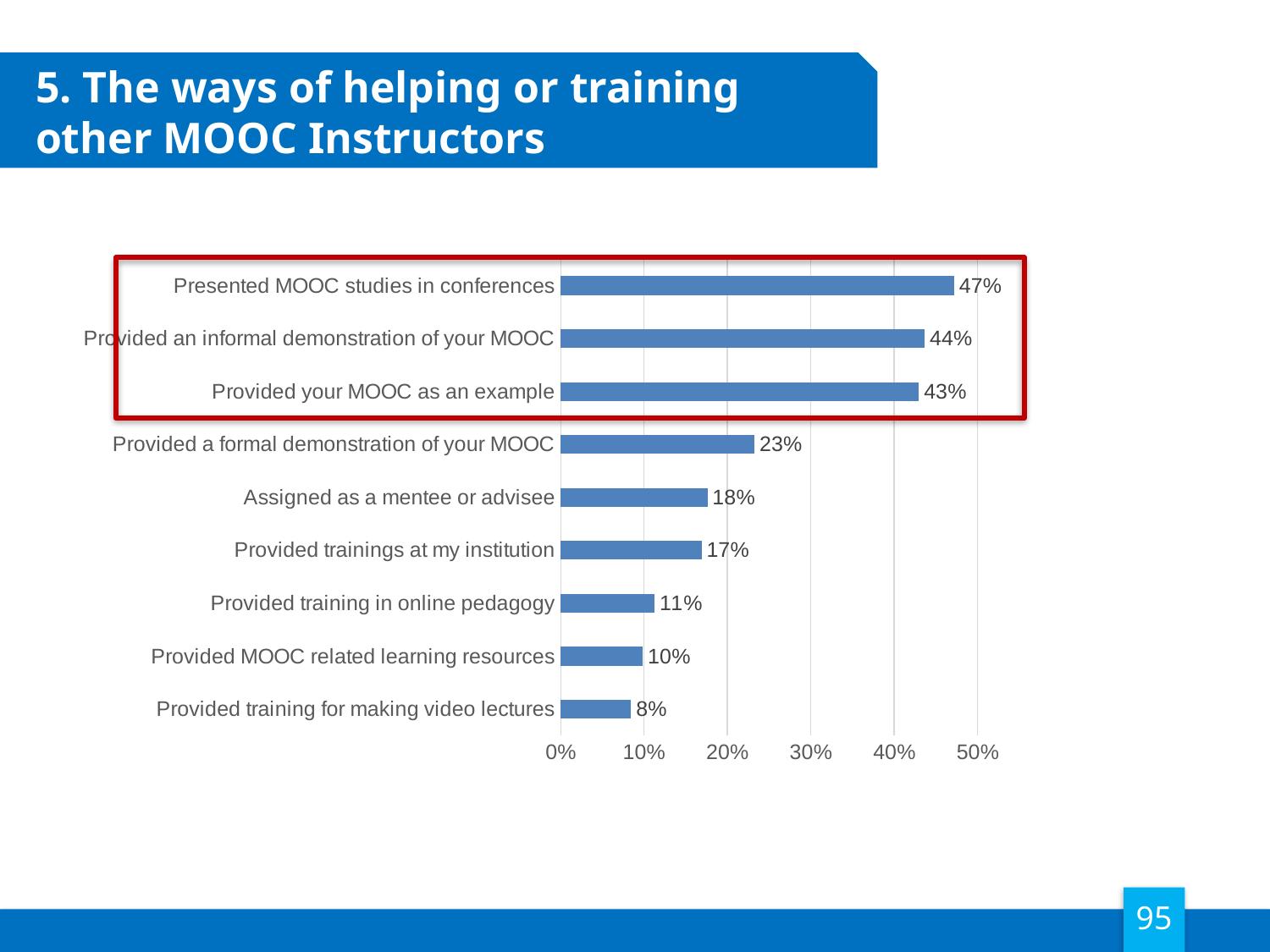
What is the value for 'Provided a formal demonstration of your MOOC'? 23% Which is larger: 'Provided an informal demonstration of your MOOC' or 'Provided a formal demonstration of your MOOC'? Provided an informal demonstration of your MOOC What percentage of respondents presented MOOC studies in conferences? 47% What kind of chart is shown on the slide? Bar chart What is the difference between 'Provided a formal demonstration of your MOOC' and 'Assigned as a mentee or advisee'? 5% What is the value for 'Provided training for making video lectures'? 8% How many categories are enclosed by the red box on the chart? 3 Which category has the highest value? Presented MOOC studies in conferences What is the difference between 'Presented MOOC studies in conferences' and 'Provided your MOOC as an example'? 4% Is the value for 'Provided training in online pedagogy' greater or less than 20%? less Which category has the lowest value? Provided training for making video lectures How many categories are shown in the chart? 9